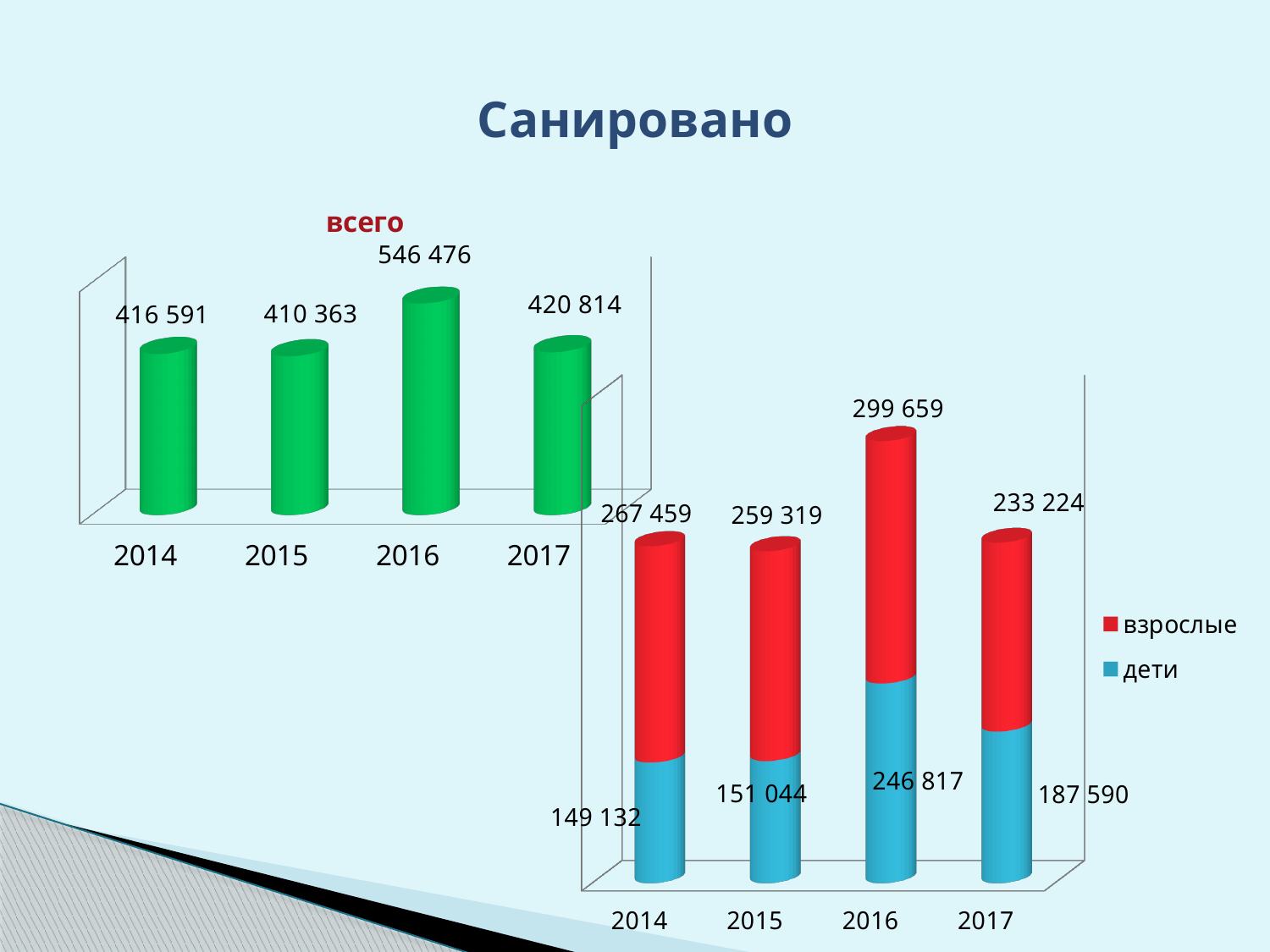
In the "всего" chart, what is the value for 2016? 546 476 In the stacked chart on the right, what is the value for дети in 2017? 187 590 In the stacked chart on the right, what is the value for взрослые in 2015? 259 319 In the "всего" chart, which year has the lowest value? 2015 In the "всего" chart, how many years are shown on the x axis? 4 In the stacked chart on the right, which year has the lowest value for взрослые? 2017 In the stacked chart on the right, how many series does the legend list? 2 In the "всего" chart, which year has the highest value? 2016 What type of chart is the "всего" chart? Bar chart In the stacked chart on the right, what is the total of the 2014 bar (взрослые plus дети)? 416 591 In the "всего" chart, what is the difference between the 2016 and 2017 values? 125 662 In the stacked chart on the right, which year has the highest value for дети? 2016